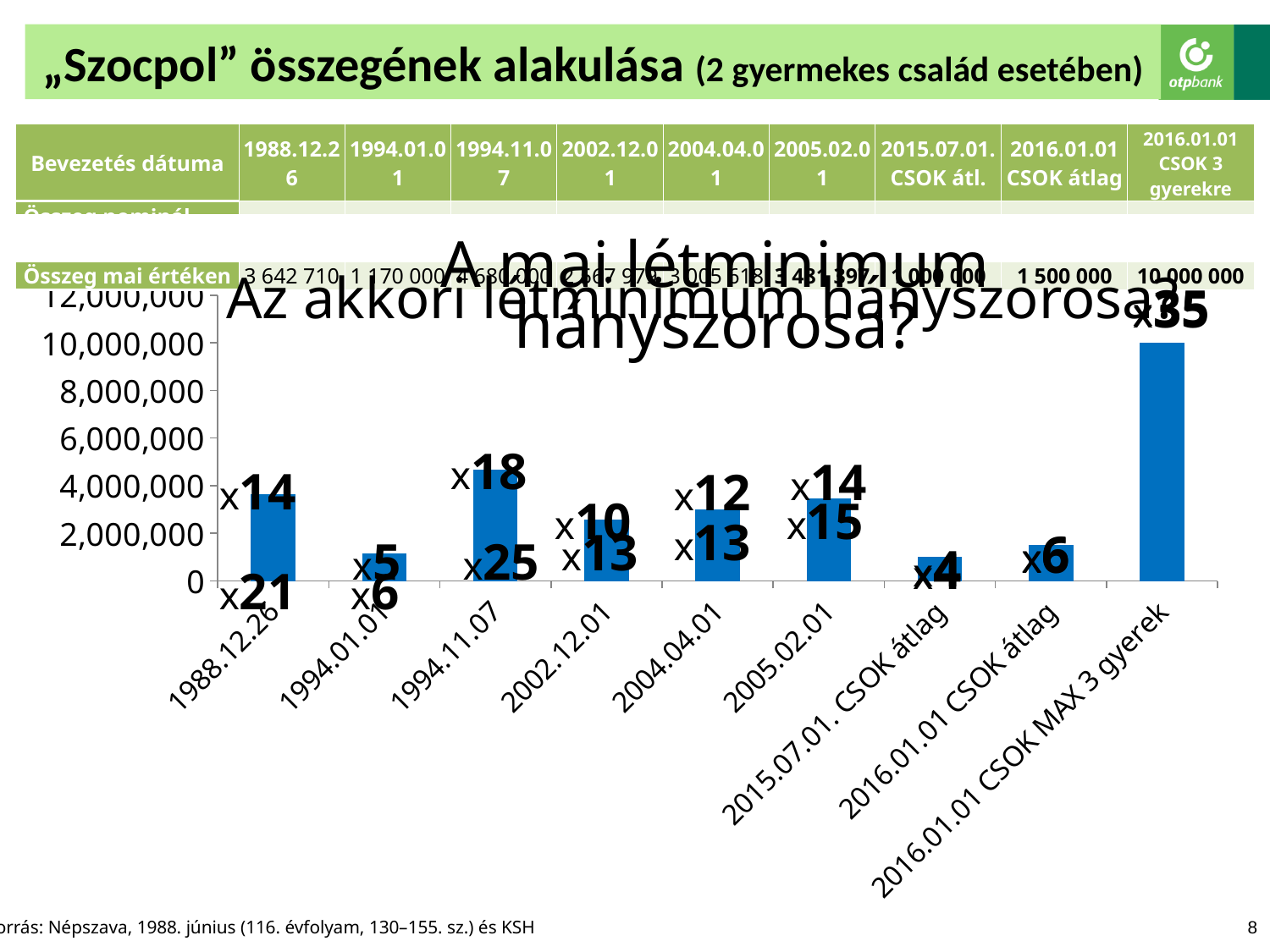
What is the value for 2016.01.01 CSOK átlag (Összeg mai értéken)? 1 500 000 Which is larger, the value for 2005.02.01 or the value for 2004.04.01? 2005.02.01 Is the value for 2005.02.01 greater or less than 4,000,000? less Which category has the highest value in the chart? 2016.01.01 CSOK MAX 3 gyerek Is the value for 1994.11.07 greater or less than 4,000,000? greater What is the highest tick value shown on the y axis of the chart? 12,000,000 What is the difference between the values for 2016.01.01 CSOK MAX 3 gyerek and 2016.01.01 CSOK átlag? 8 500 000 How many categories are plotted along the x axis of the chart? 9 What kind of chart is shown on the slide? bar chart What is the value for 2016.01.01 CSOK MAX 3 gyerek (Összeg mai értéken)? 10 000 000 Which is larger, the value for 1994.11.07 or the value for 1988.12.26? 1994.11.07 What is the value for 1988.12.26 (Összeg mai értéken)? 3 642 710